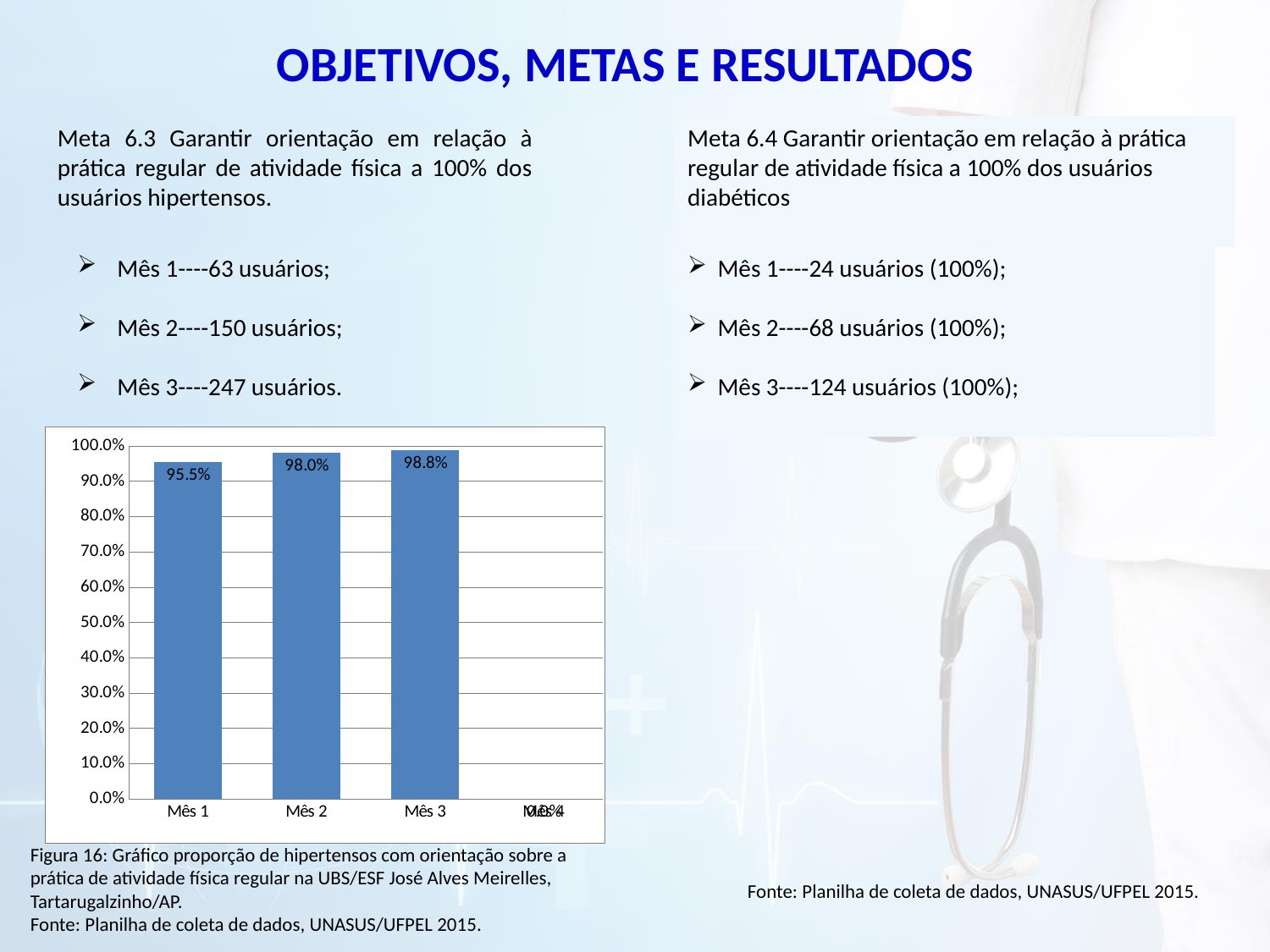
How many bars are drawn in the chart? 3 Which is larger in the bar chart, the value for Mês 2 or the value for Mês 3? Mês 3 What is the value shown for Mês 1 in the bar chart? 95.5% What is the value shown for Mês 3 in the bar chart? 98.8% Which month has the highest value in the bar chart? Mês 3 What kind of chart is shown on the slide? Bar chart Is the value for Mês 1 in the bar chart greater or less than 90.0%? greater What is the value shown for Mês 2 in the bar chart? 98.0% Among Mês 1, Mês 2 and Mês 3, which has the lowest value in the bar chart? Mês 1 Do the values in the bar chart rise or fall from Mês 1 to Mês 3? Rise What is the difference between the values for Mês 2 and Mês 1 in the bar chart? 2.5 percentage points What is the difference between the values for Mês 3 and Mês 1 in the bar chart? 3.3 percentage points